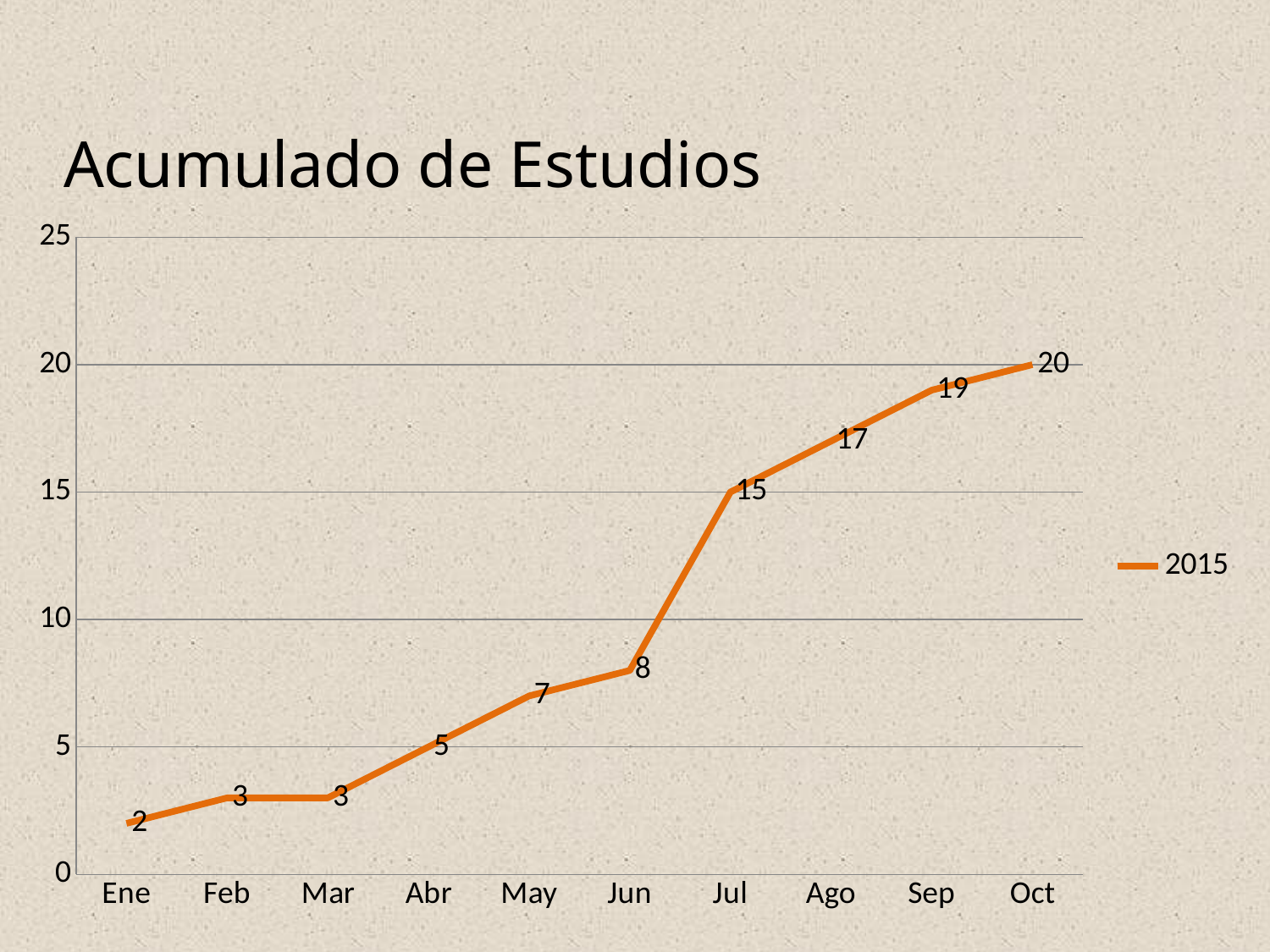
Which month has the lowest value? Ene What is the difference between the values for Jul and Jun? 7 What is the value for Abr? 5 How many series does the legend list? 1 Which month has the highest value? Oct What is the value for Oct? 20 Which is larger, the value for Sep or the value for Ago? Sep What is the value for Jul? 15 How many months are plotted on the x axis? 10 What kind of chart is shown? line chart Do the values rise or fall from Ene to Oct? rise What is the title of the chart? Acumulado de Estudios